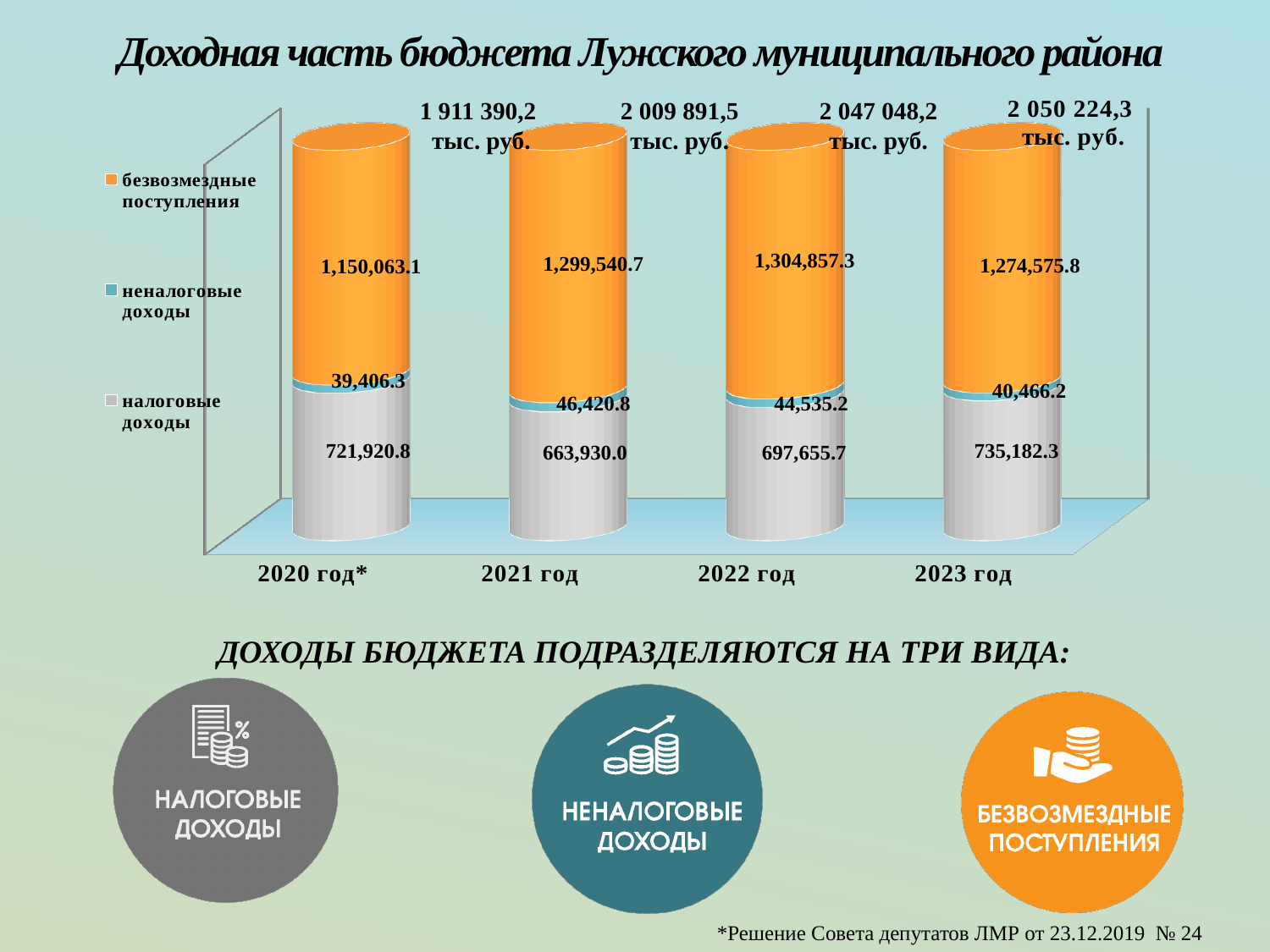
Is the value of неналоговые доходы larger in 2021 год or in 2023 год? 2021 год What is the total budget revenue shown above the bar for 2020 год*? 1 911 390,2 тыс. руб. Which year has the highest value of безвозмездные поступления? 2022 год What is the value of налоговые доходы for 2023 год? 735,182.3 What is the value of безвозмездные поступления for 2021 год? 1,299,540.7 How many series does the chart legend list? 3 What is the value of неналоговые доходы for 2020 год*? 39,406.3 How many years are shown on the x axis of the chart? 4 What kind of chart is shown on the slide? Stacked bar chart What is the difference between налоговые доходы in 2023 год and in 2020 год*? 13,261.5 Do the total revenues printed above the bars rise or fall from 2020 to 2023? Rise Which year has the lowest value of налоговые доходы? 2021 год